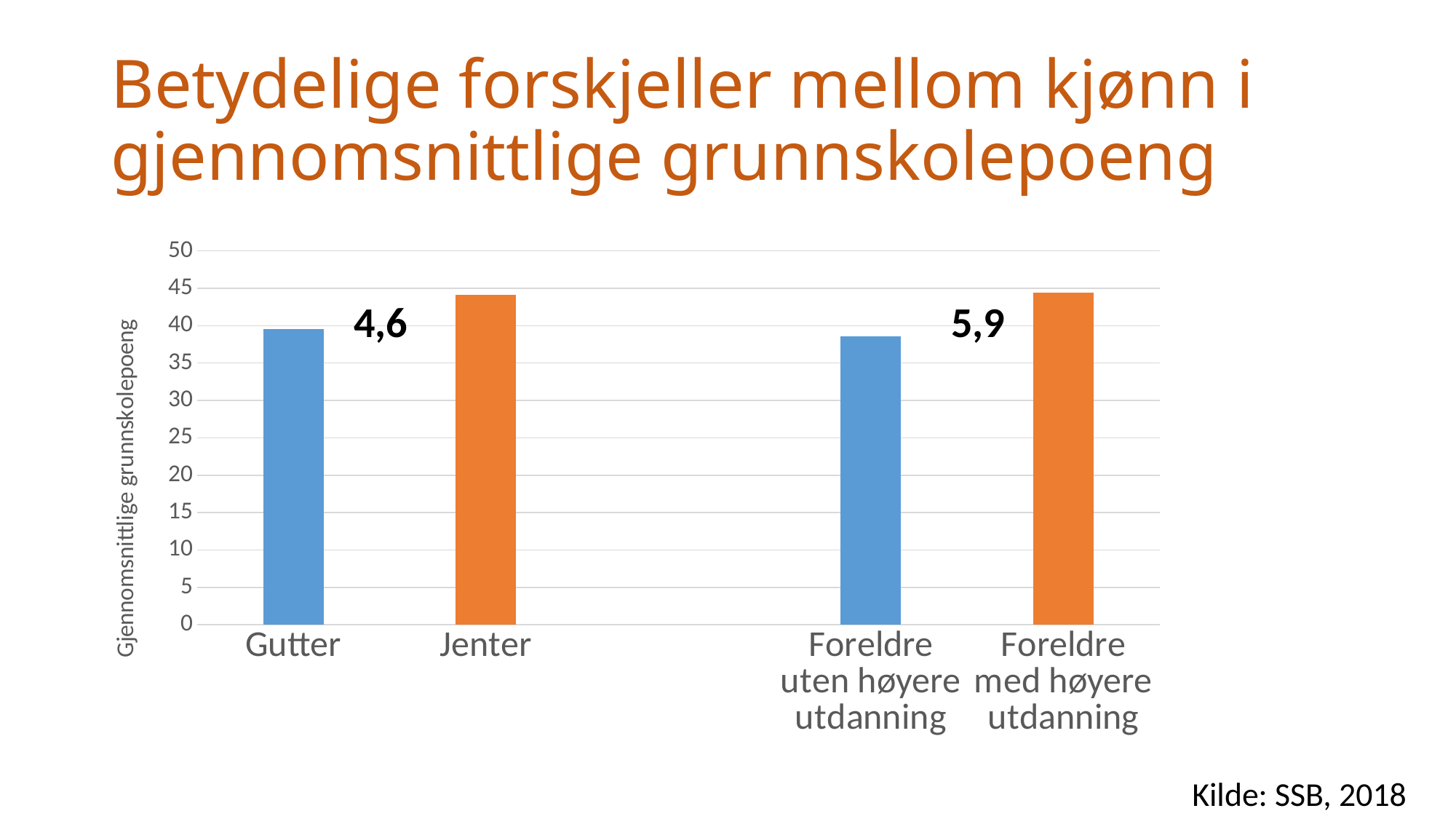
What kind of chart is shown on the slide? bar chart Is the value for Jenter greater or less than 45? less What difference in grunnskolepoeng is printed between Foreldre uten høyere utdanning and Foreldre med høyere utdanning? 5,9 Is the value for Foreldre uten høyere utdanning greater or less than 40? less Which bar is taller, Foreldre uten høyere utdanning or Foreldre med høyere utdanning? Foreldre med høyere utdanning How many bars are plotted in the chart? 4 What is the label on the vertical axis of the chart? Gjennomsnittlige grunnskolepoeng What difference in grunnskolepoeng is printed between Gutter and Jenter? 4,6 What source is cited for the chart data? Kilde: SSB, 2018 Is the value for Jenter greater or less than 40? greater Which bar is taller, Gutter or Jenter? Jenter